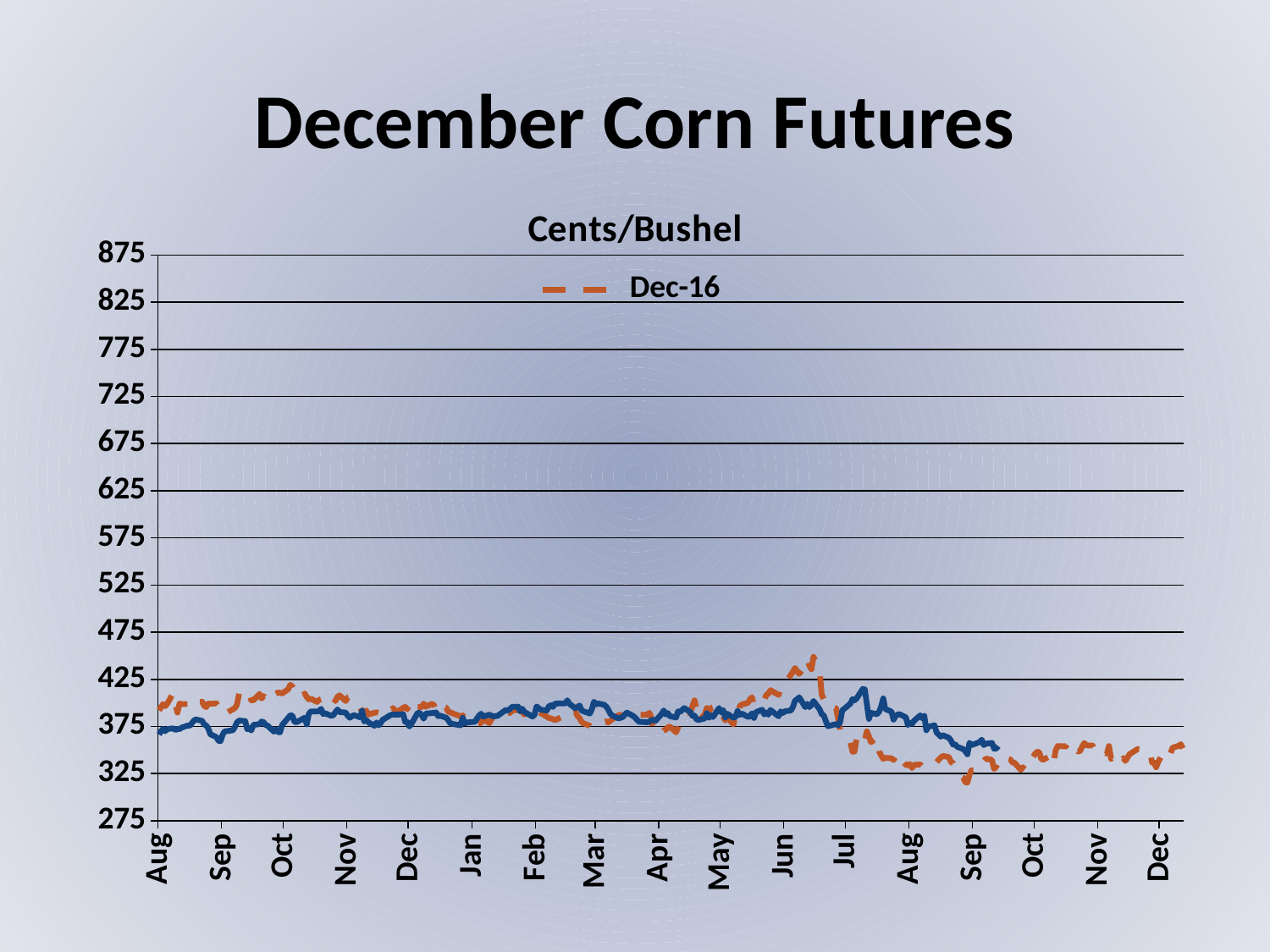
What is the highest value shown on the y axis? 875 Is the Dec-16 series higher at the first Aug label or at the final Dec label? first Aug label What is the title printed above the chart's plot area? Cents/Bushel What series name appears in the chart's legend? Dec-16 Is the value of the Dec-16 series around the first Oct label greater or less than 375? greater What kind of chart is shown on the slide? line chart How many month labels are shown along the x axis? 17 What is the lowest value shown on the y axis? 275 Is the value of the Dec-16 series at the final Dec point greater or less than 375? less Is the peak value of the Dec-16 series, reached around Jun, greater or less than 425? greater How many series does the chart's legend list? 1 Does the Dec-16 series rise or fall between Jun and Aug? fall